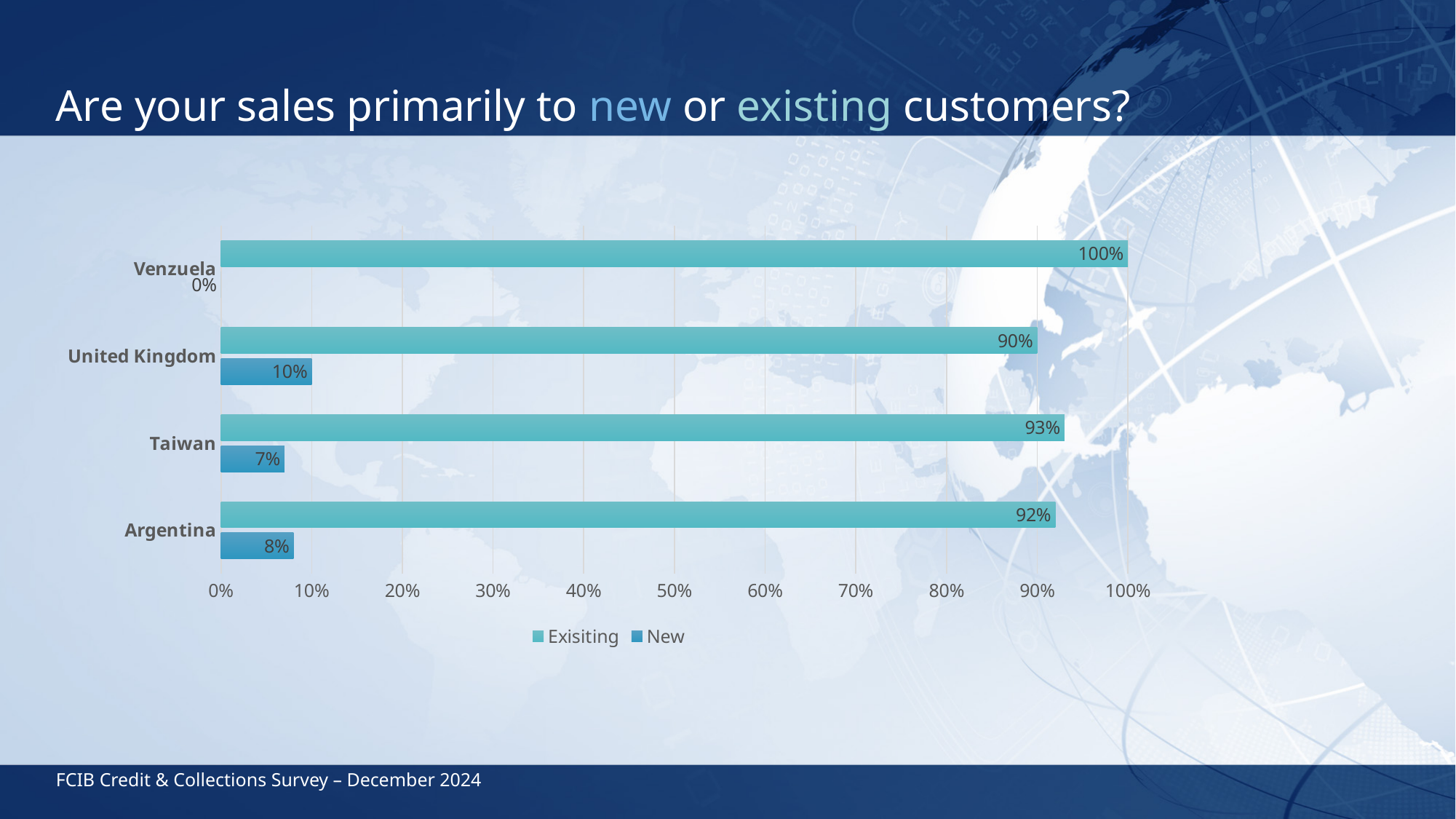
How many categories are shown on the chart? 4 How many series does the legend list? 2 What is the difference between the Existing and New values for the United Kingdom? 80% Which category has the highest Existing value? Venzuela What are the two series names listed in the legend? Exisiting and New Which category has the lowest New value? Venzuela What is the New value for Venzuela? 0% What is the Existing value for Taiwan? 93% What kind of chart is shown on the slide? Bar chart Which is larger, the New value for Argentina or the New value for Taiwan? Argentina What is the New value for the United Kingdom? 10% What is the Existing value for Argentina? 92%